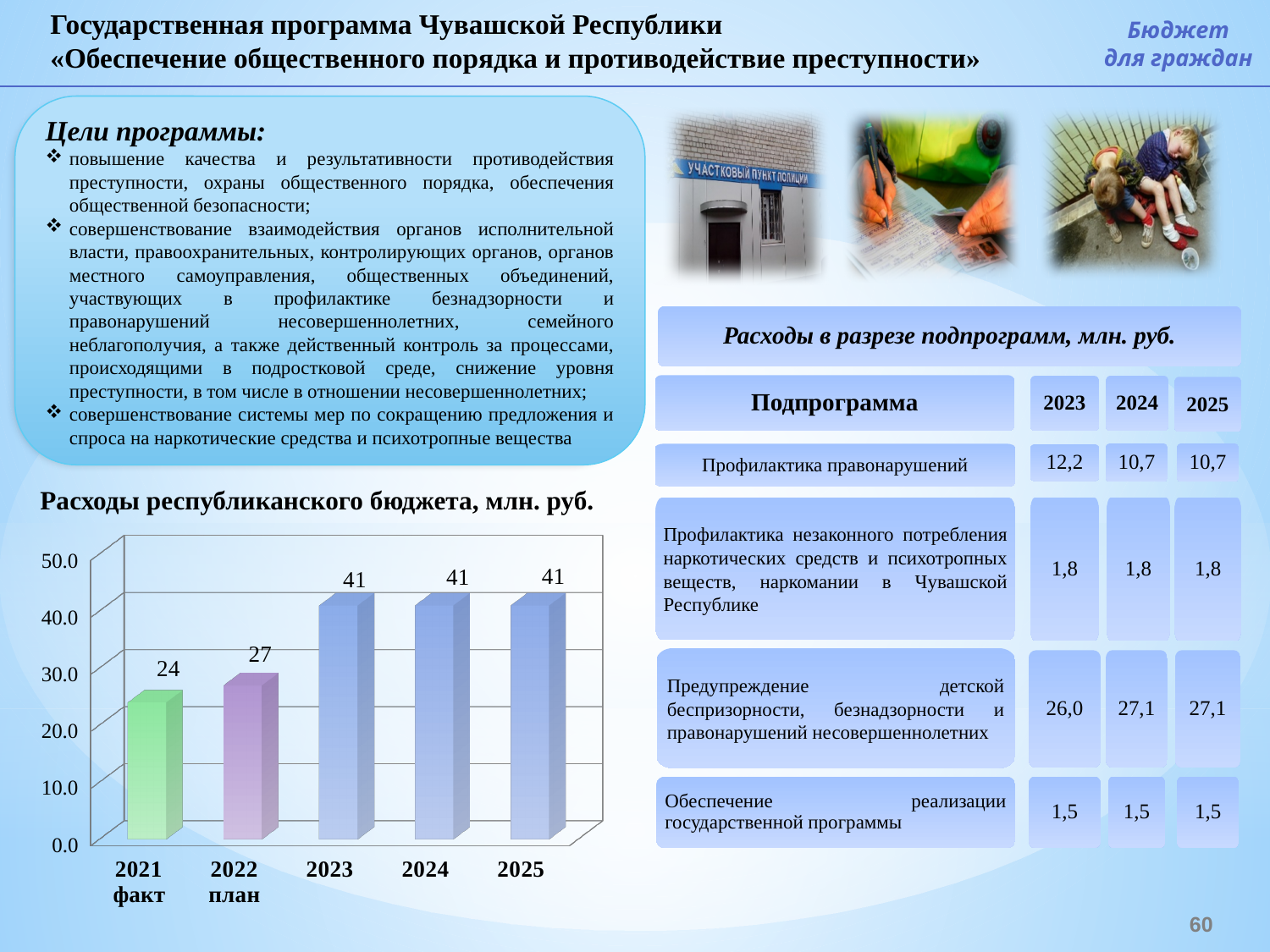
What type of chart is shown under the title "Расходы республиканского бюджета, млн. руб."? bar chart What is the value for 2025 in the chart "Расходы республиканского бюджета, млн. руб."? 41 What is the value for 2023 in the chart "Расходы республиканского бюджета, млн. руб."? 41 What is the value for 2021 факт in the chart "Расходы республиканского бюджета, млн. руб."? 24 What is the difference between the values for 2023 and 2021 факт in the chart "Расходы республиканского бюджета, млн. руб."? 17 Which is larger in the chart "Расходы республиканского бюджета, млн. руб.": the value for 2022 план or the value for 2024? 2024 What is the value for 2022 план in the chart "Расходы республиканского бюджета, млн. руб."? 27 How many bars are plotted in the chart "Расходы республиканского бюджета, млн. руб."? 5 Do the values in the chart "Расходы республиканского бюджета, млн. руб." rise or fall from 2021 факт to 2023? rise What is the difference between the values for 2022 план and 2021 факт in the chart "Расходы республиканского бюджета, млн. руб."? 3 Is the value for 2022 план greater or less than 30.0 in the chart "Расходы республиканского бюджета, млн. руб."? less Which category has the lowest value in the chart "Расходы республиканского бюджета, млн. руб."? 2021 факт